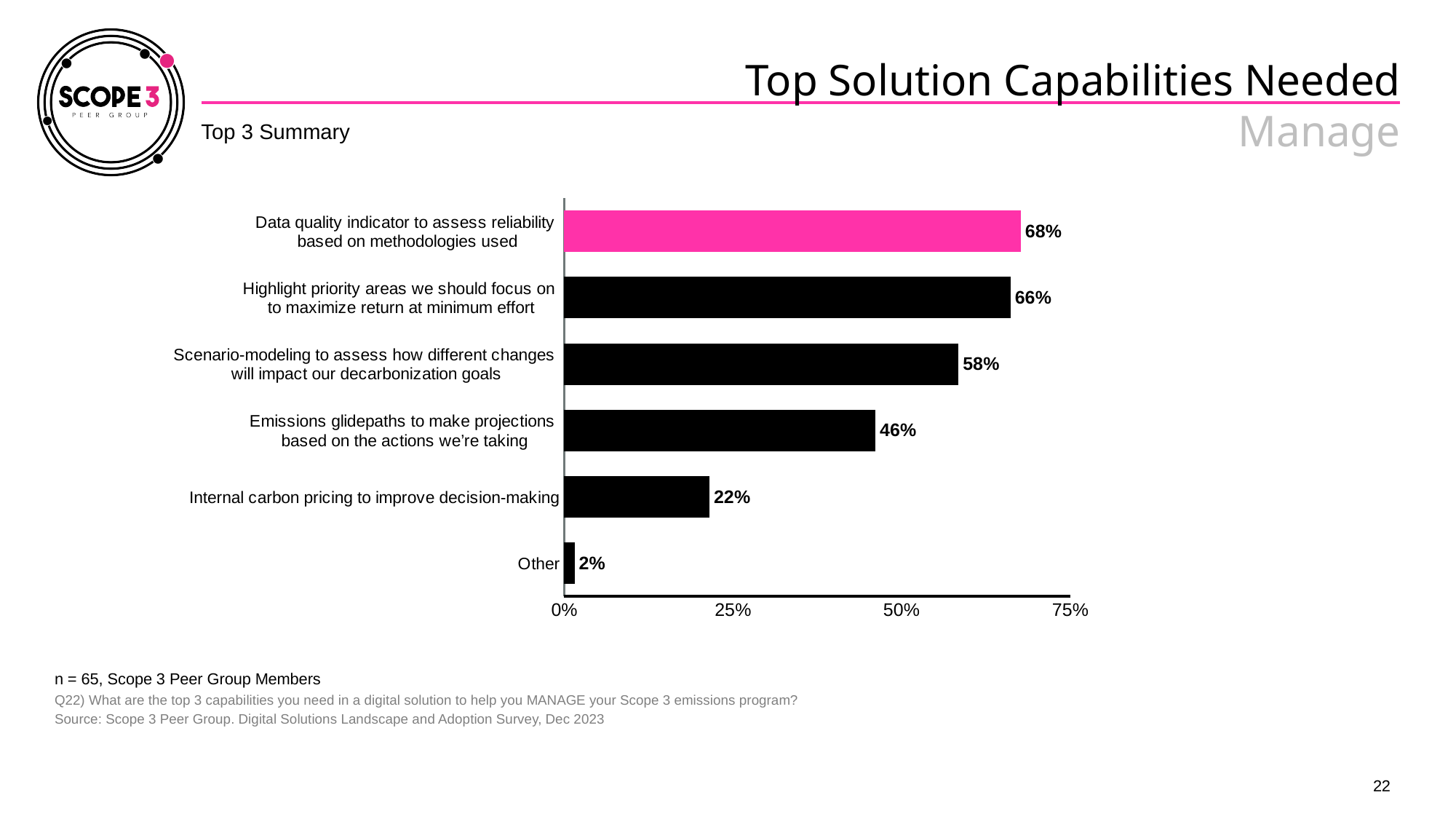
What percentage is shown for "Data quality indicator to assess reliability based on methodologies used"? 68% What percentage is shown for "Emissions glidepaths to make projections based on the actions we're taking"? 46% Which is larger: the value for "Highlight priority areas we should focus on to maximize return at minimum effort" or the value for "Scenario-modeling to assess how different changes will impact our decarbonization goals"? Highlight priority areas we should focus on to maximize return at minimum effort What is the difference between the highest and lowest values in the chart? 66% What is the value for "Internal carbon pricing to improve decision-making"? 22% What kind of chart is shown on the slide? Bar chart Which category has the lowest percentage? Other What is the difference between the values for "Scenario-modeling to assess how different changes will impact our decarbonization goals" and "Emissions glidepaths to make projections based on the actions we're taking"? 12% Which capability has the highest percentage? Data quality indicator to assess reliability based on methodologies used Which bar is highlighted in pink? Data quality indicator to assess reliability based on methodologies used Is the value for "Internal carbon pricing to improve decision-making" greater or less than 25%? less How many categories are shown in the chart? 6